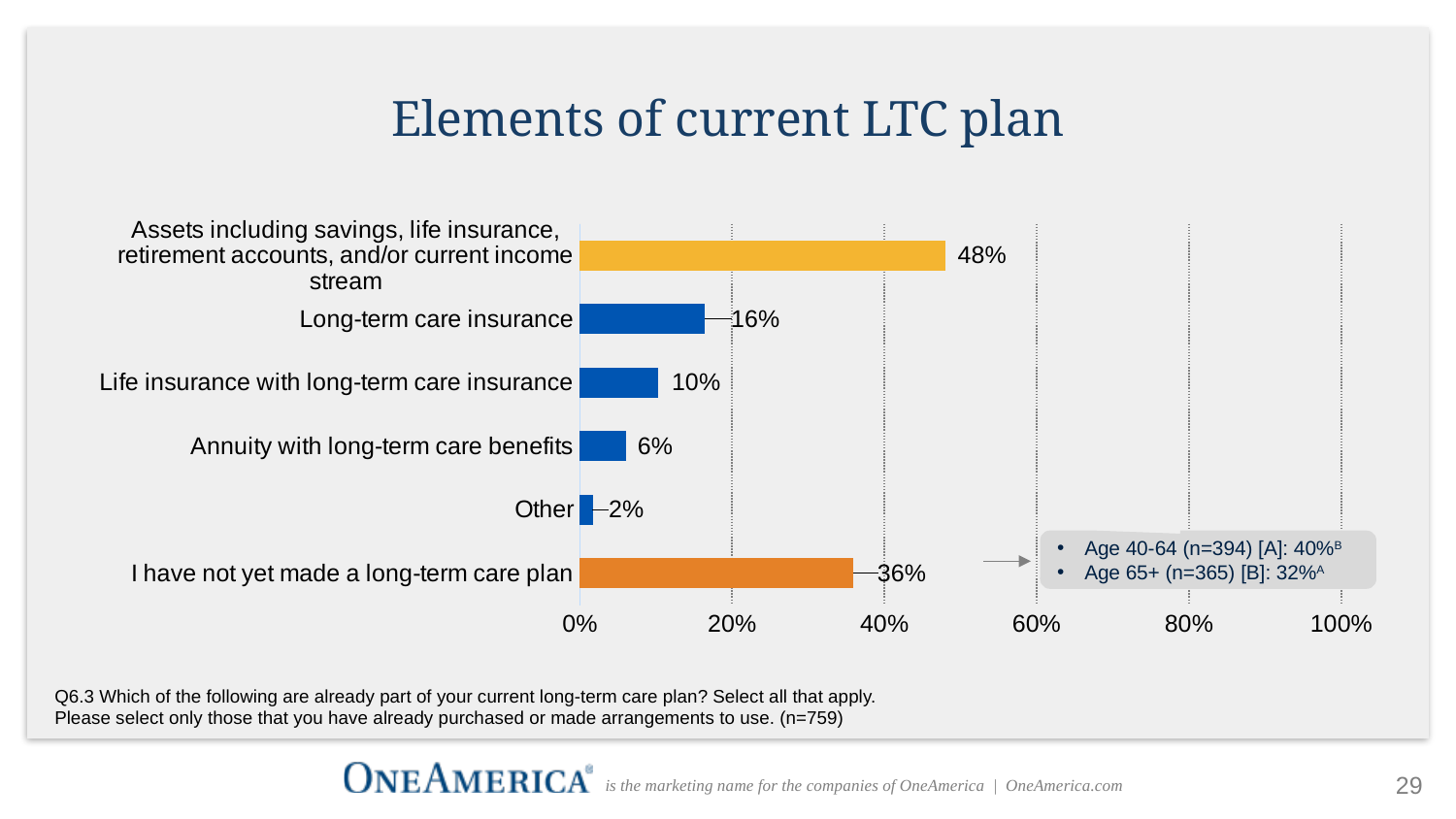
What is the title of the chart? Elements of current LTC plan What is the value for Long-term care insurance? 16% Is the value for 'I have not yet made a long-term care plan' greater or less than 40%? less What percentage of respondents have assets including savings, life insurance, retirement accounts, and/or current income stream as part of their current LTC plan? 48% Which category has the highest value? Assets including savings, life insurance, retirement accounts, and/or current income stream What kind of chart is shown on the slide? Bar chart What is the difference between the value for Long-term care insurance and the value for Life insurance with long-term care insurance? 6% How many categories are shown in the chart? 6 Which category has the lowest value? Other Which is larger: the value for Life insurance with long-term care insurance or the value for Annuity with long-term care benefits? Life insurance with long-term care insurance What is the value for Annuity with long-term care benefits? 6% What percentage of respondents have not yet made a long-term care plan? 36%